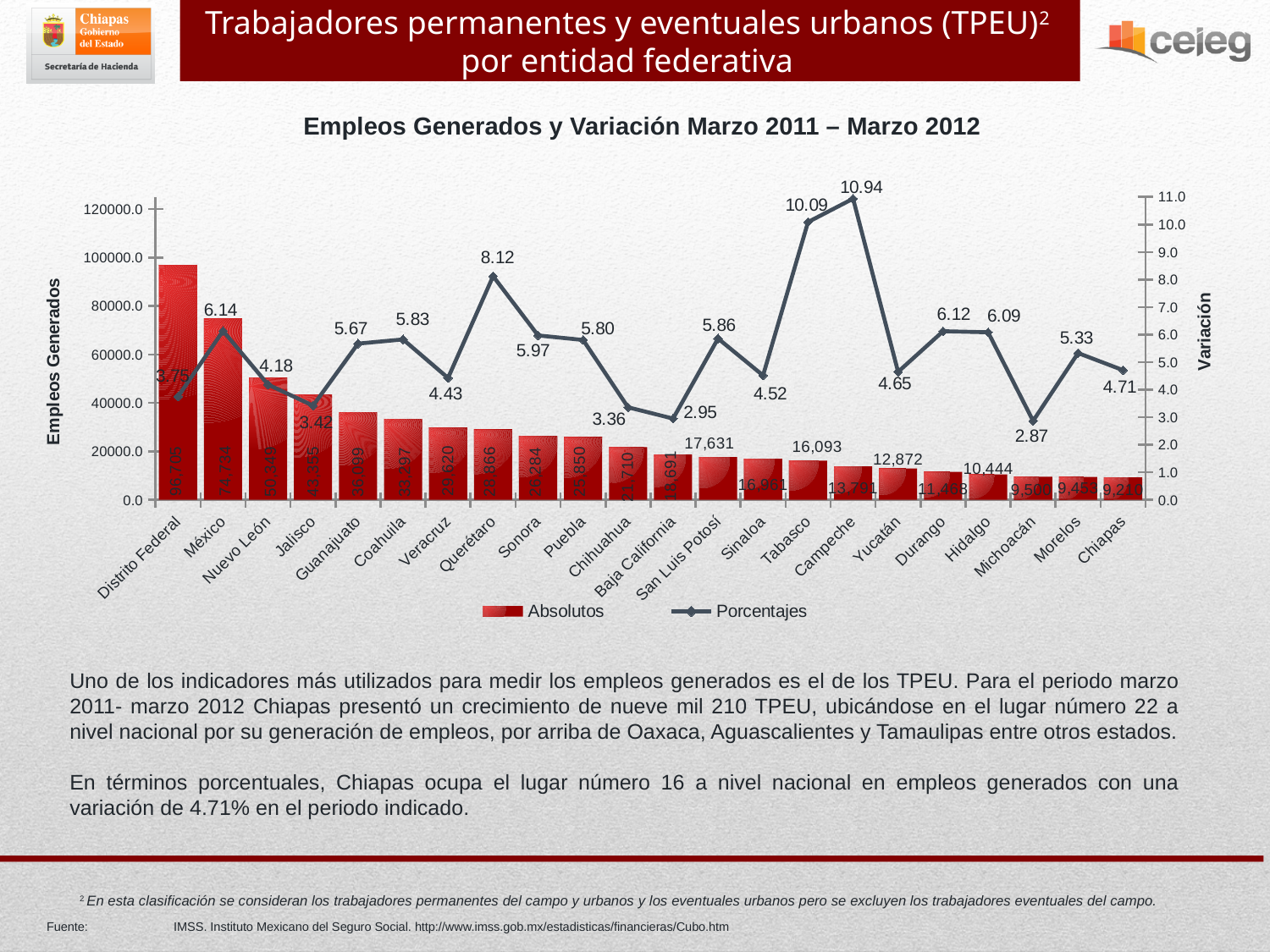
How many entities are shown on the x axis of the chart? 22 How many series does the legend list? 2 Is the Absolutos value for Distrito Federal greater or less than 80000.0? greater Do the Absolutos bars rise or fall from left to right along the x axis? fall What is the Absolutos value for Chiapas? 9,210 What is the difference between the Porcentajes values of Campeche and Tabasco? 0.85 Which entity has the highest Absolutos value? Distrito Federal Which entity has the lowest Porcentajes value? Michoacán Which has a higher Porcentajes value, Durango or Hidalgo? Durango Which entity has the highest Porcentajes value? Campeche What is the Porcentajes value for Campeche? 10.94 What is the Porcentajes value for Querétaro? 8.12